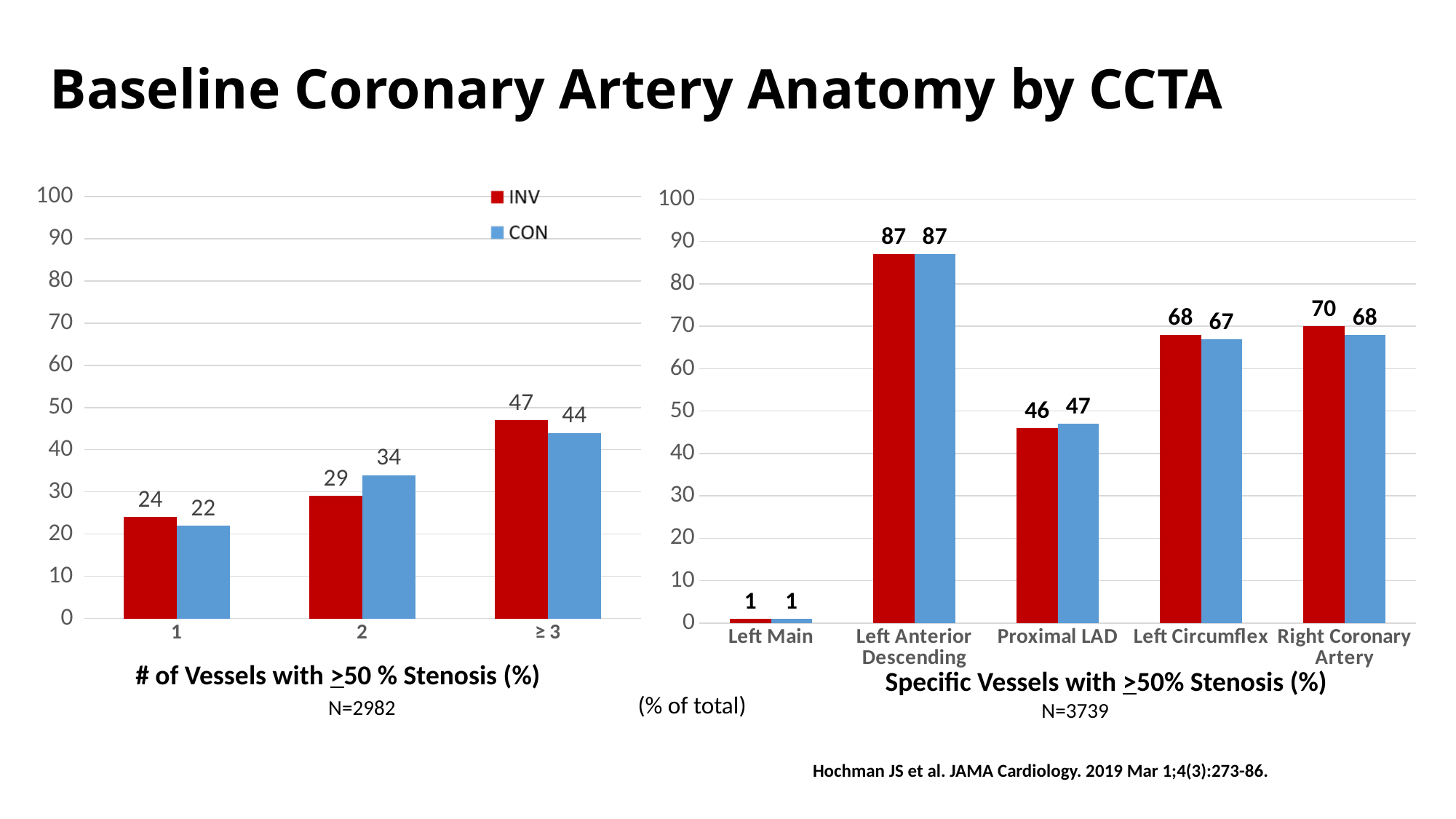
In the right chart (Specific Vessels with ≥50% Stenosis), what is the difference between the INV and CON values for Right Coronary Artery? 2 In the right chart (Specific Vessels with ≥50% Stenosis), what is the CON value for Left Circumflex? 67 In the right chart (Specific Vessels with ≥50% Stenosis), which vessel has the lowest values? Left Main In the left chart (# of Vessels with ≥50% Stenosis), which is larger for 2 vessels, INV or CON? CON In the left chart (# of Vessels with ≥50% Stenosis), which category has the highest INV value? ≥ 3 In the left chart (# of Vessels with ≥50% Stenosis), do the INV values rise or fall from 1 to ≥ 3 vessels? rise In the left chart (# of Vessels with ≥50% Stenosis), what is the INV value for 1 vessel? 24 In the left chart (# of Vessels with ≥50% Stenosis), what is the CON value for 2 vessels? 34 In the right chart (Specific Vessels with ≥50% Stenosis), which vessel has the highest INV value? Left Anterior Descending In the left chart (# of Vessels with ≥50% Stenosis), what is the difference between the INV and CON values for ≥ 3 vessels? 3 How many vessel categories are shown in the right chart (Specific Vessels with ≥50% Stenosis)? 5 How many series does the legend list? 2